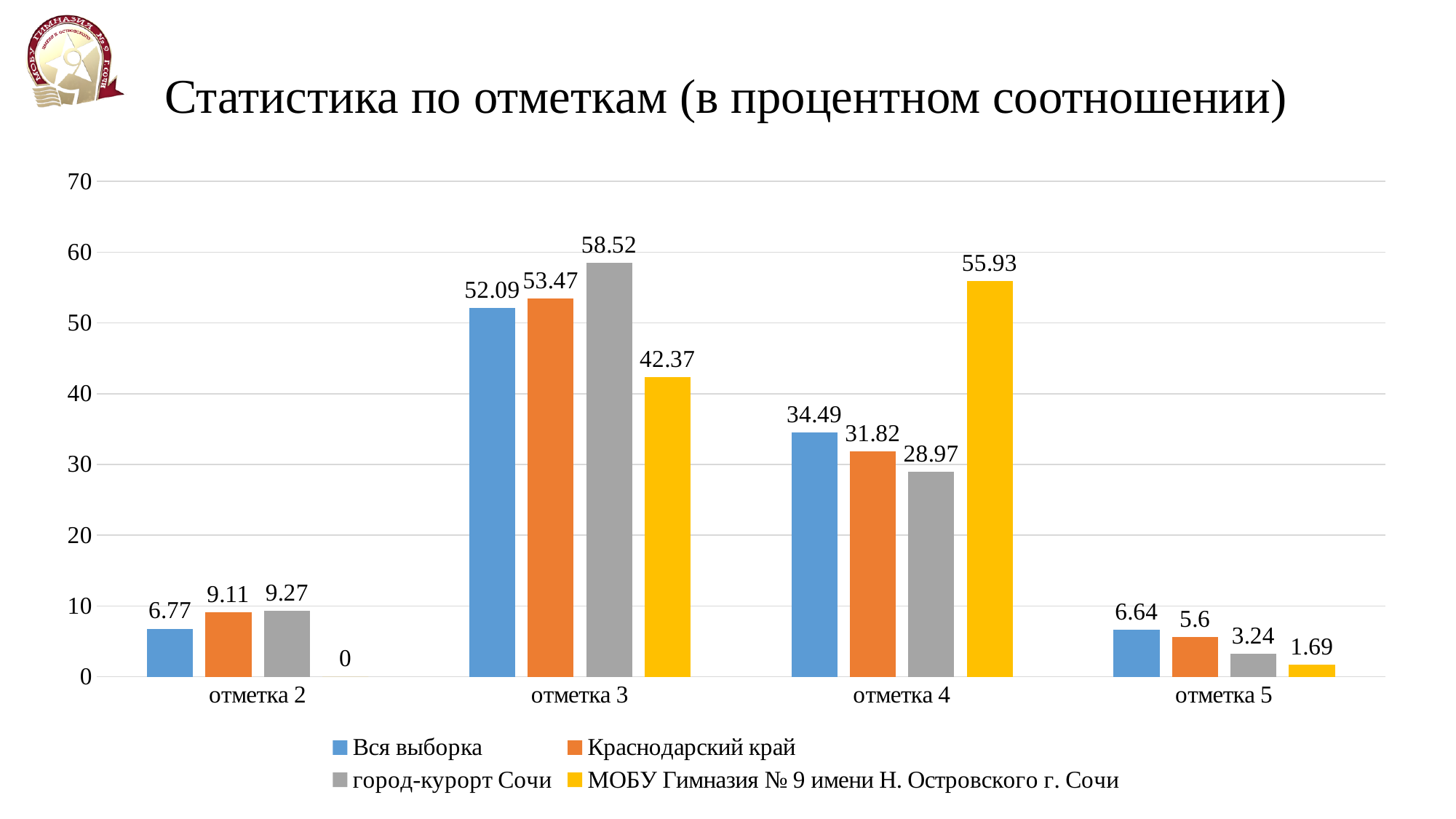
What is the difference between the Краснодарский край and Вся выборка values at отметка 4? 2.67 What is the value for город-курорт Сочи at отметка 5? 3.24 Is the value for МОБУ Гимназия № 9 имени Н. Островского г. Сочи at отметка 3 greater or less than 50? less What kind of chart is shown on the slide? bar chart What is the value for Вся выборка at отметка 3? 52.09 What is the value for МОБУ Гимназия № 9 имени Н. Островского г. Сочи at отметка 4? 55.93 What is the value for МОБУ Гимназия № 9 имени Н. Островского г. Сочи at отметка 2? 0 How many categories are shown on the x axis? 4 Which series has the highest value at отметка 3? город-курорт Сочи Which series has the lowest value at отметка 5? МОБУ Гимназия № 9 имени Н. Островского г. Сочи Which is larger at отметка 2: the value for Краснодарский край or the value for город-курорт Сочи? город-курорт Сочи How many series does the legend list? 4